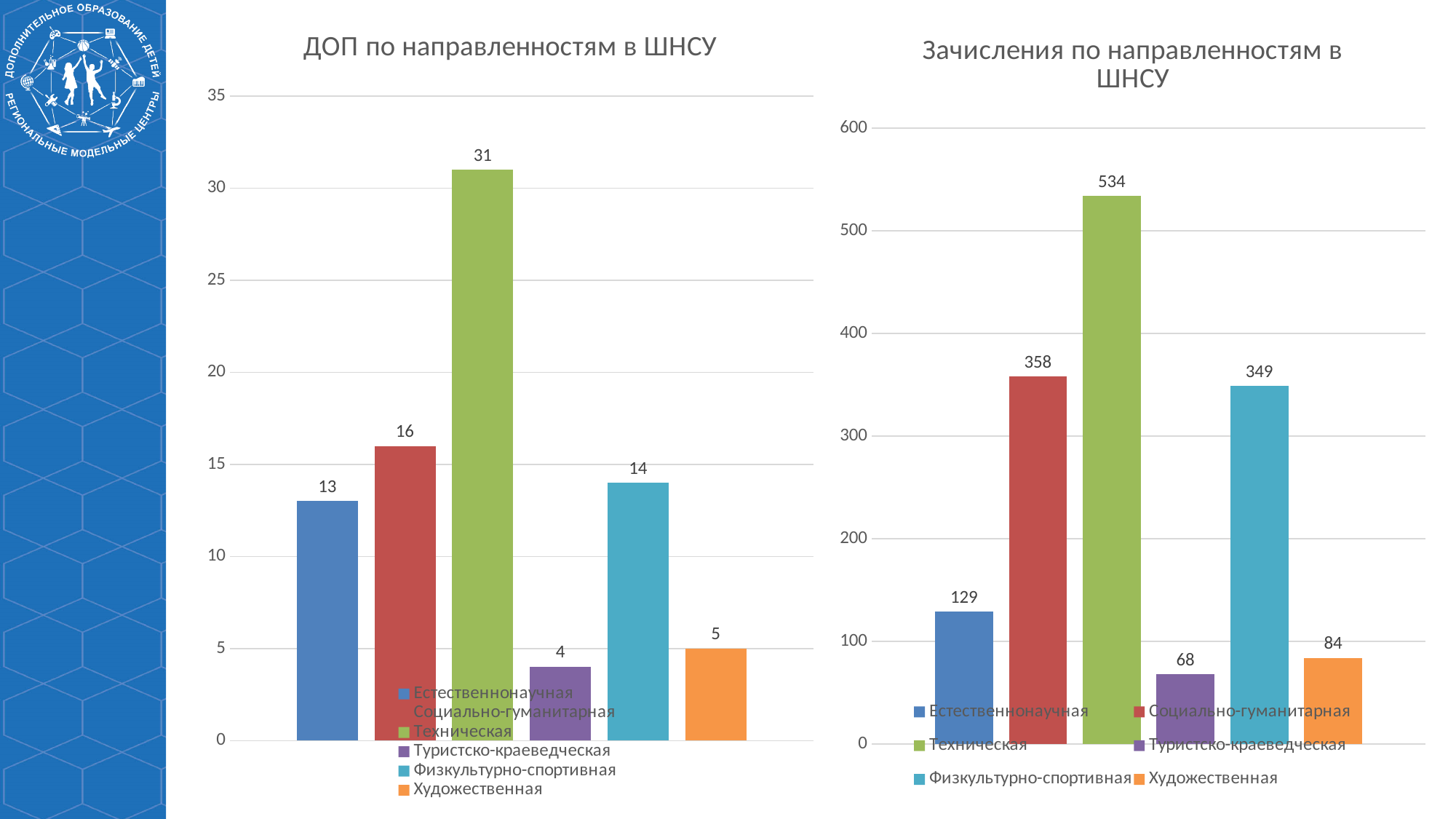
In the chart 'Зачисления по направленностям в ШНСУ', which category has the highest value? Техническая In the chart 'ДОП по направленностям в ШНСУ', what is the difference between Социально-гуманитарная and Естественнонаучная? 3 In the chart 'Зачисления по направленностям в ШНСУ', what is the value for Туристско-краеведческая? 68 What type of chart is 'ДОП по направленностям в ШНСУ'? Bar chart In the chart 'Зачисления по направленностям в ШНСУ', what is the value for Физкультурно-спортивная? 349 How many entries does the legend of the chart 'Зачисления по направленностям в ШНСУ' list? 6 In the chart 'ДОП по направленностям в ШНСУ', which category has the lowest value? Туристско-краеведческая In the chart 'ДОП по направленностям в ШНСУ', what is the value for Техническая? 31 In the chart 'Зачисления по направленностям в ШНСУ', which is larger: Естественнонаучная or Художественная? Естественнонаучная In the chart 'Зачисления по направленностям в ШНСУ', what is the difference between Техническая and Социально-гуманитарная? 176 In the chart 'ДОП по направленностям в ШНСУ', what is the value for Художественная? 5 In the chart 'ДОП по направленностям в ШНСУ', how many bars are plotted? 6